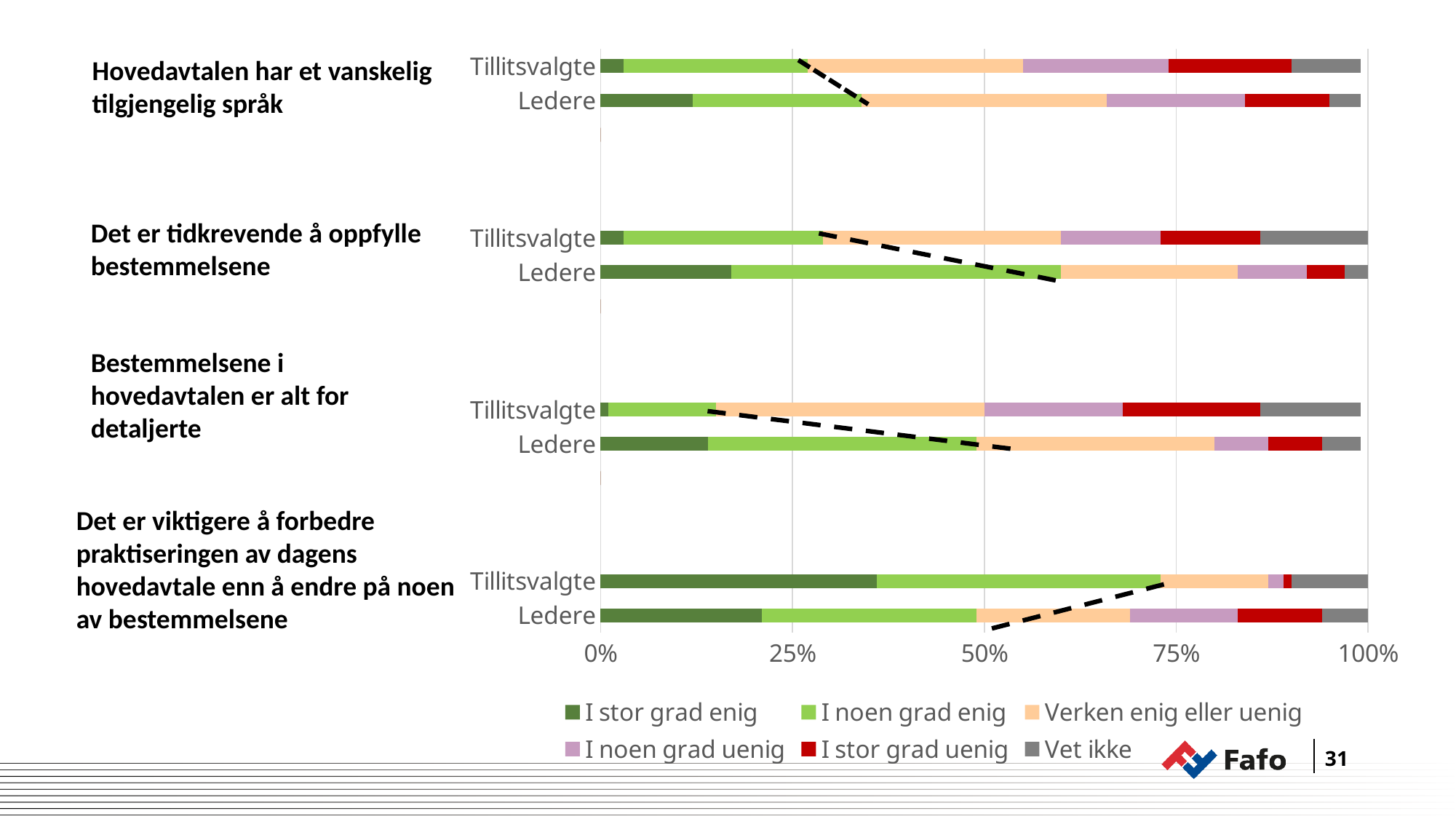
Which two respondent groups are shown for each statement? Tillitsvalgte and Ledere How many statements are compared in the chart? 4 For the statement 'Det er viktigere å forbedre praktiseringen av dagens hovedavtale enn å endre på noen av bestemmelsene', which group has the larger 'I stor grad enig' share, Tillitsvalgte or Ledere? Tillitsvalgte For the statement 'Det er tidkrevende å oppfylle bestemmelsene', is the combined share of 'I stor grad enig' and 'I noen grad enig' for Ledere greater or less than 50%? greater For the statement 'Det er tidkrevende å oppfylle bestemmelsene', which group has the larger 'I stor grad enig' share, Tillitsvalgte or Ledere? Ledere Which colour represents 'I stor grad uenig' in the legend? Red How many bars are plotted in the chart? 8 How many series does the legend list? 6 For the statement 'Hovedavtalen har et vanskelig tilgjengelig språk', is the 'I stor grad enig' share for Ledere greater or less than 25%? less What kind of chart is shown on the slide? Stacked bar chart For the statement 'Det er viktigere å forbedre praktiseringen av dagens hovedavtale enn å endre på noen av bestemmelsene', is the 'I stor grad enig' share for Tillitsvalgte greater or less than 25%? greater